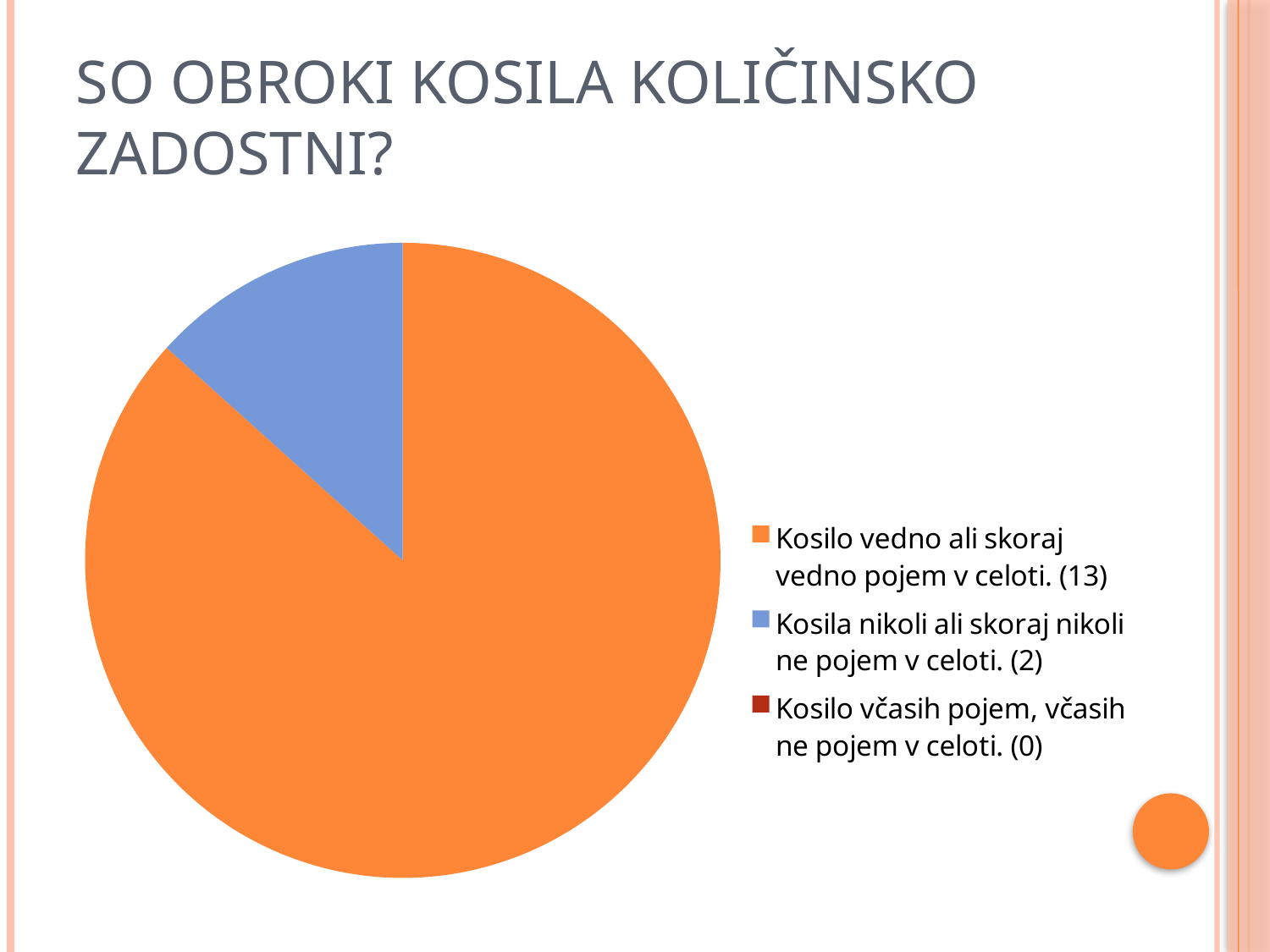
Which category has the smallest value in the legend? Kosilo včasih pojem, včasih ne pojem v celoti. How many categories does the legend list? 3 What kind of chart is shown on the slide? pie chart What colour is the slice for "Kosila nikoli ali skoraj nikoli ne pojem v celoti"? blue What is the difference between the number who always eat the whole lunch (13) and the number who never do (2)? 11 How many respondents answered "Kosilo včasih pojem, včasih ne pojem v celoti"? 0 How many respondents answered "Kosilo vedno ali skoraj vedno pojem v celoti"? 13 Which is larger: the value for "Kosilo vedno ali skoraj vedno pojem v celoti" or for "Kosila nikoli ali skoraj nikoli ne pojem v celoti"? Kosilo vedno ali skoraj vedno pojem v celoti. What is the title of the slide containing the chart? SO OBROKI KOSILA KOLIČINSKO ZADOSTNI? How many respondents answered "Kosila nikoli ali skoraj nikoli ne pojem v celoti"? 2 Which category has the largest slice of the pie? Kosilo vedno ali skoraj vedno pojem v celoti. What is the total number of responses across all categories in the legend? 15